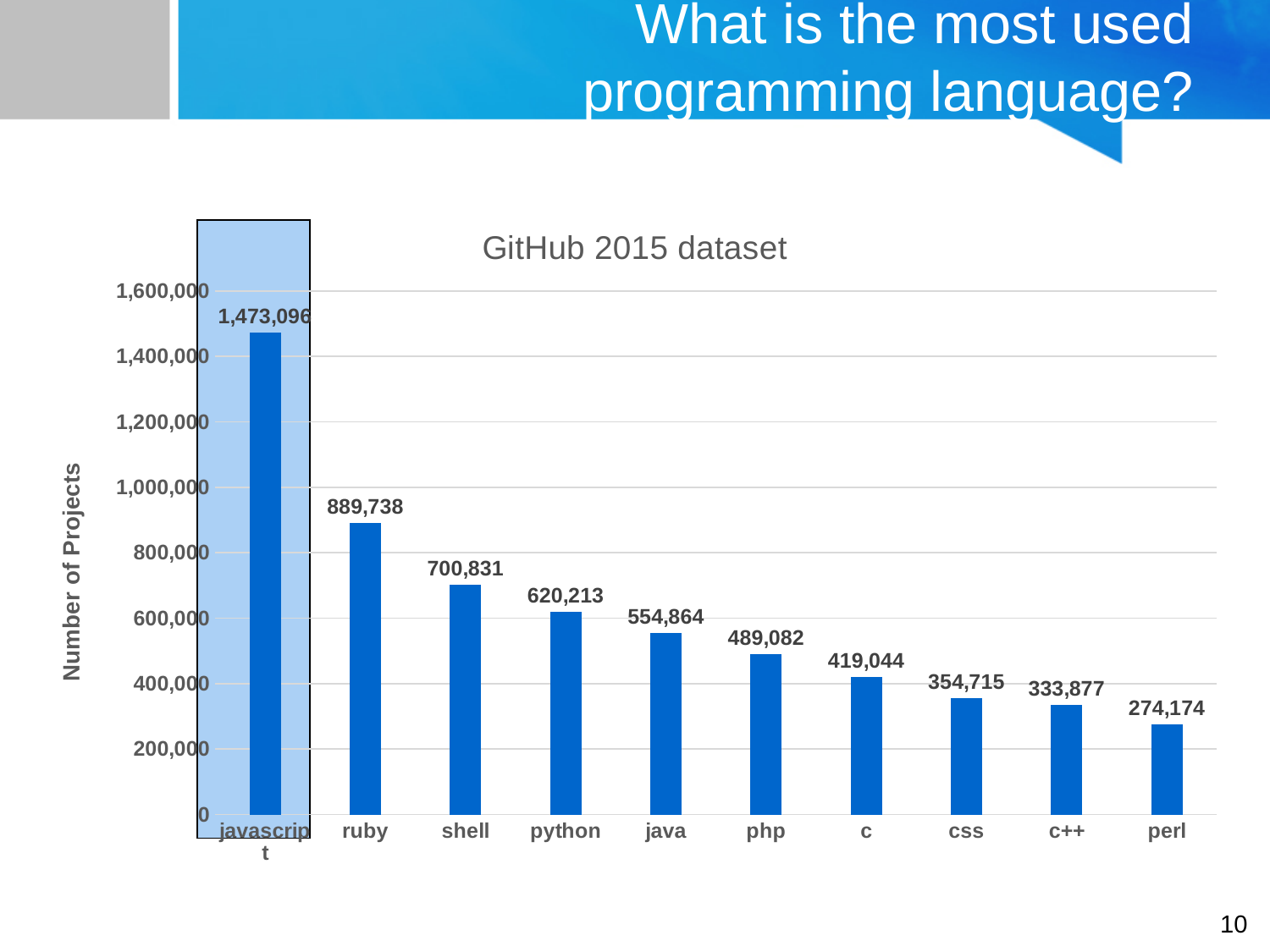
Which has more projects, java or php? java Which language has the highest number of projects? javascript What type of chart is shown on the slide? bar chart What is the difference in number of projects between javascript and ruby? 583,358 What is the number of projects for c++? 333,877 Which language has the lowest number of projects? perl What is the number of projects for python? 620,213 What is the number of projects for ruby? 889,738 How many programming languages are shown in the chart? 10 What is the difference in number of projects between shell and python? 80,618 What is the title of the chart? GitHub 2015 dataset Is the value for c greater or less than 400,000? greater